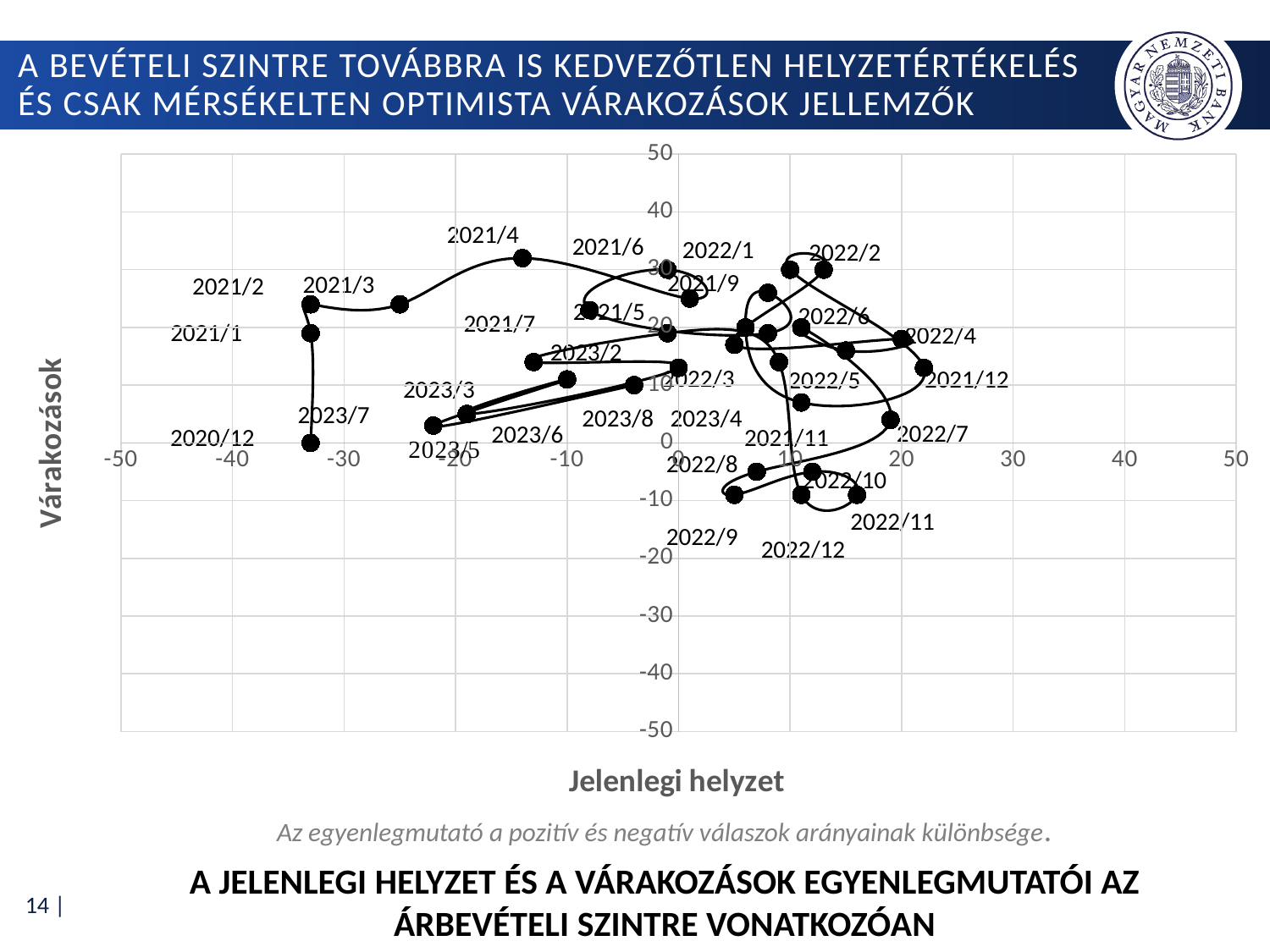
Is the Várakozások value for 2022/8 greater or less than 0? less What is the label of the vertical axis? Várakozások Is the Jelenlegi helyzet value for 2021/12 greater or less than 10? greater Is the Jelenlegi helyzet value for 2020/12 greater or less than -30? less Which point has the higher Várakozások value, 2021/4 or 2020/12? 2021/4 Which point has the higher Jelenlegi helyzet value, 2022/4 or 2021/2? 2022/4 What kind of chart is shown on the slide? scatter chart What is the label of the horizontal axis? Jelenlegi helyzet